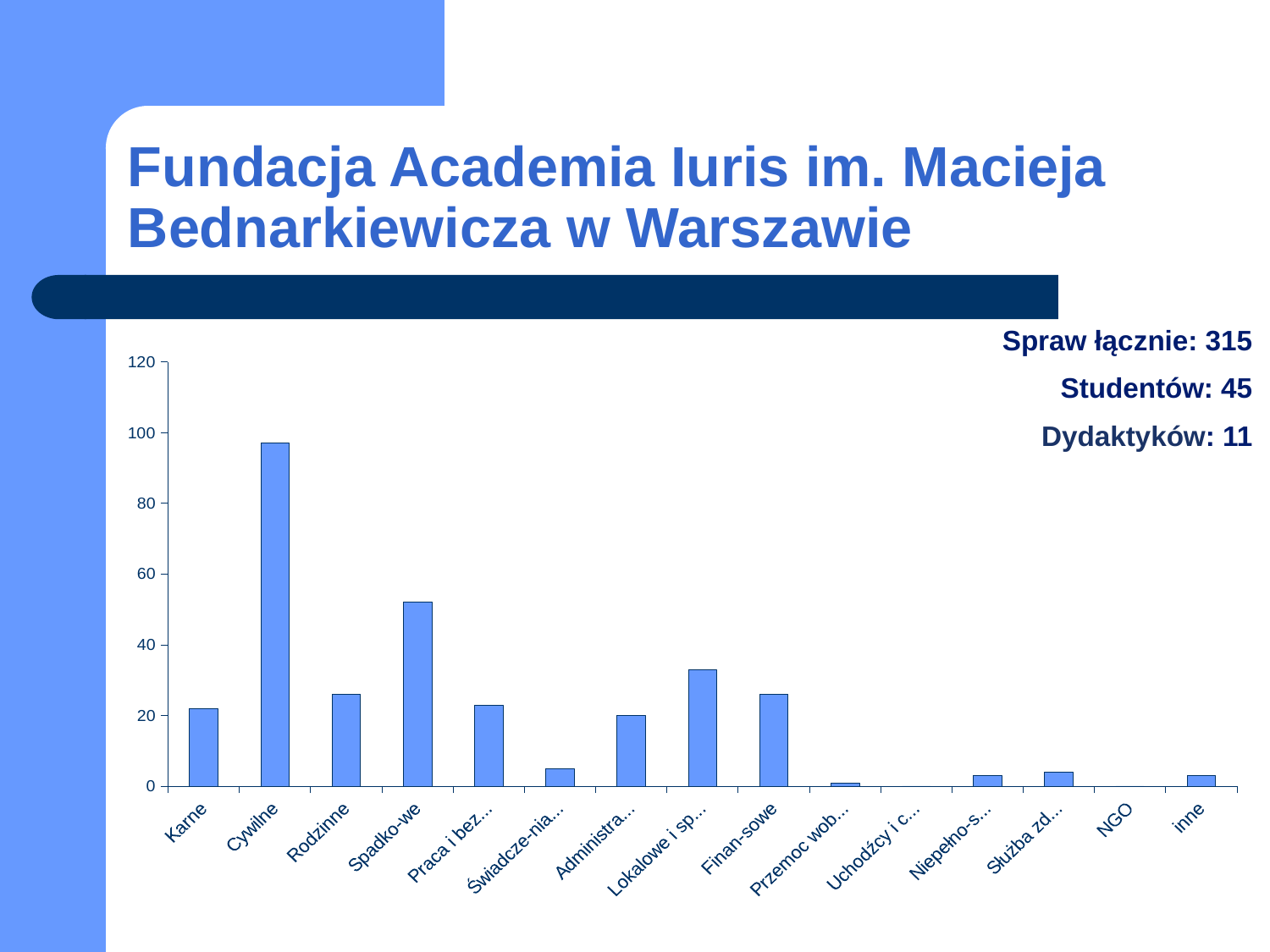
Which category has the highest bar in the chart? Cywilne Is the value for Spadko-we greater or less than 40? greater Is the value for Spadko-we greater or less than 60? less Is the value for Świadcze-nia... greater or less than 20? less What kind of chart is shown on the slide? bar chart How many categories are shown on the x axis of the chart? 15 Which is larger, the value for Lokalowe i sp... or the value for Rodzinne? Lokalowe i sp... What is the highest value shown on the y axis of the chart? 120 Which is larger, the value for Cywilne or the value for Spadko-we? Cywilne